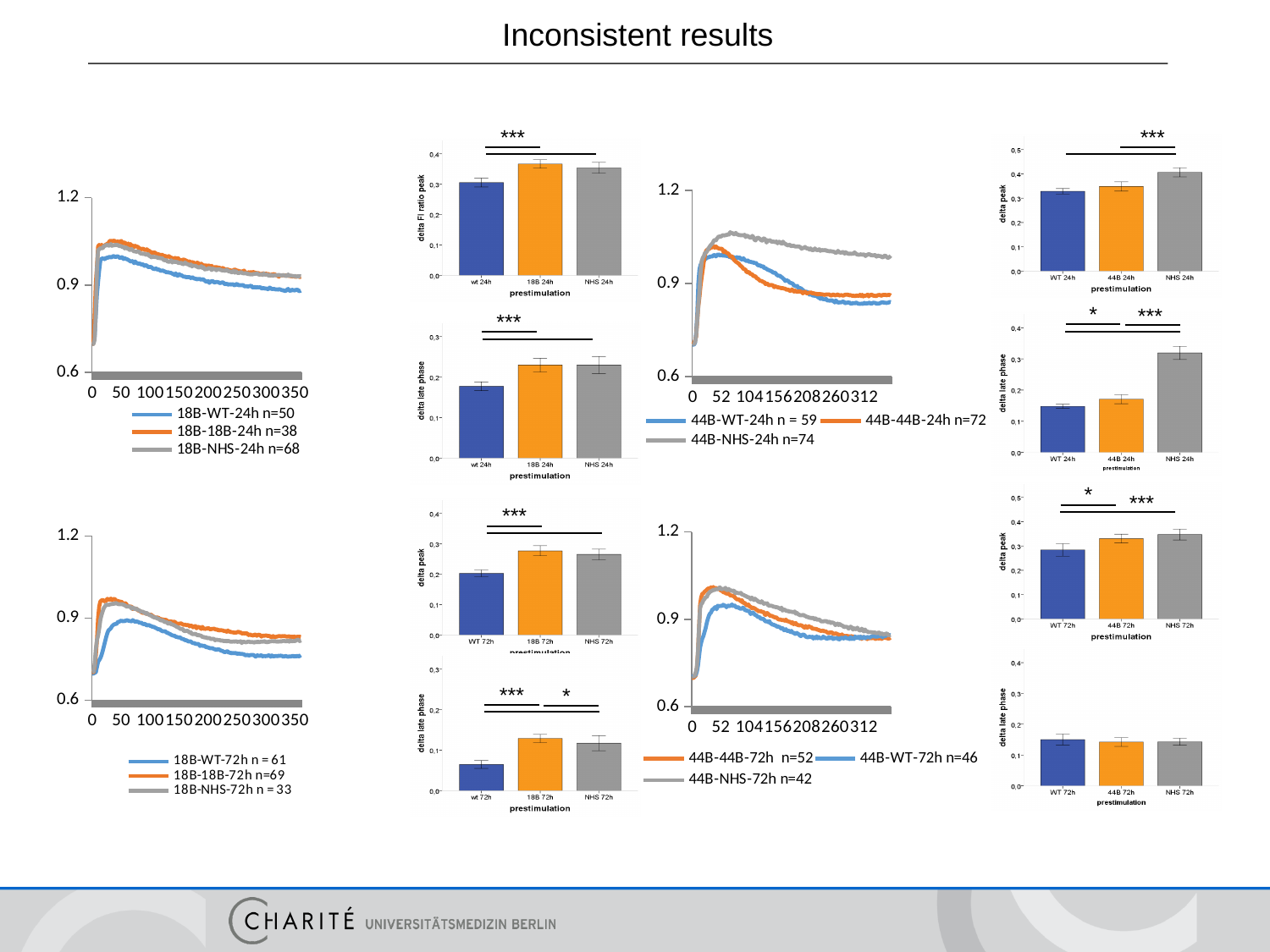
In the lower 'delta late phase' bar chart in the middle column (72h), is the value for wt 72h greater or less than 0.1? less In the top-left line chart (18B 24h), how many series does the legend list? 3 In the 'delta peak' bar chart for 72h in the right column, which category has the lowest value? WT 72h In the 'delta FI ratio peak' bar chart (middle column, top), which category has the lowest value? wt 24h In the top-left line chart, what is the n value given in the legend for 18B-NHS-24h? 68 What kind of chart is the 'delta FI ratio peak' chart in the middle column? bar chart In the upper 'delta late phase' bar chart in the right column (24h), is the value for NHS 24h larger or smaller than the value for WT 24h? larger In the top 'delta peak' bar chart in the right column (24h), which category has the highest value? NHS 24h In the 'delta FI ratio peak' bar chart (middle column, top), how many bars are there? 3 In the 'delta FI ratio peak' bar chart (middle column, top), is the value for 18B 24h greater or less than 0.3? greater In the upper 'delta late phase' bar chart in the middle column (24h), is the value for wt 24h greater or less than 0.2? less What kind of chart is the top-left chart with the 18B-WT-24h, 18B-18B-24h and 18B-NHS-24h series? line chart